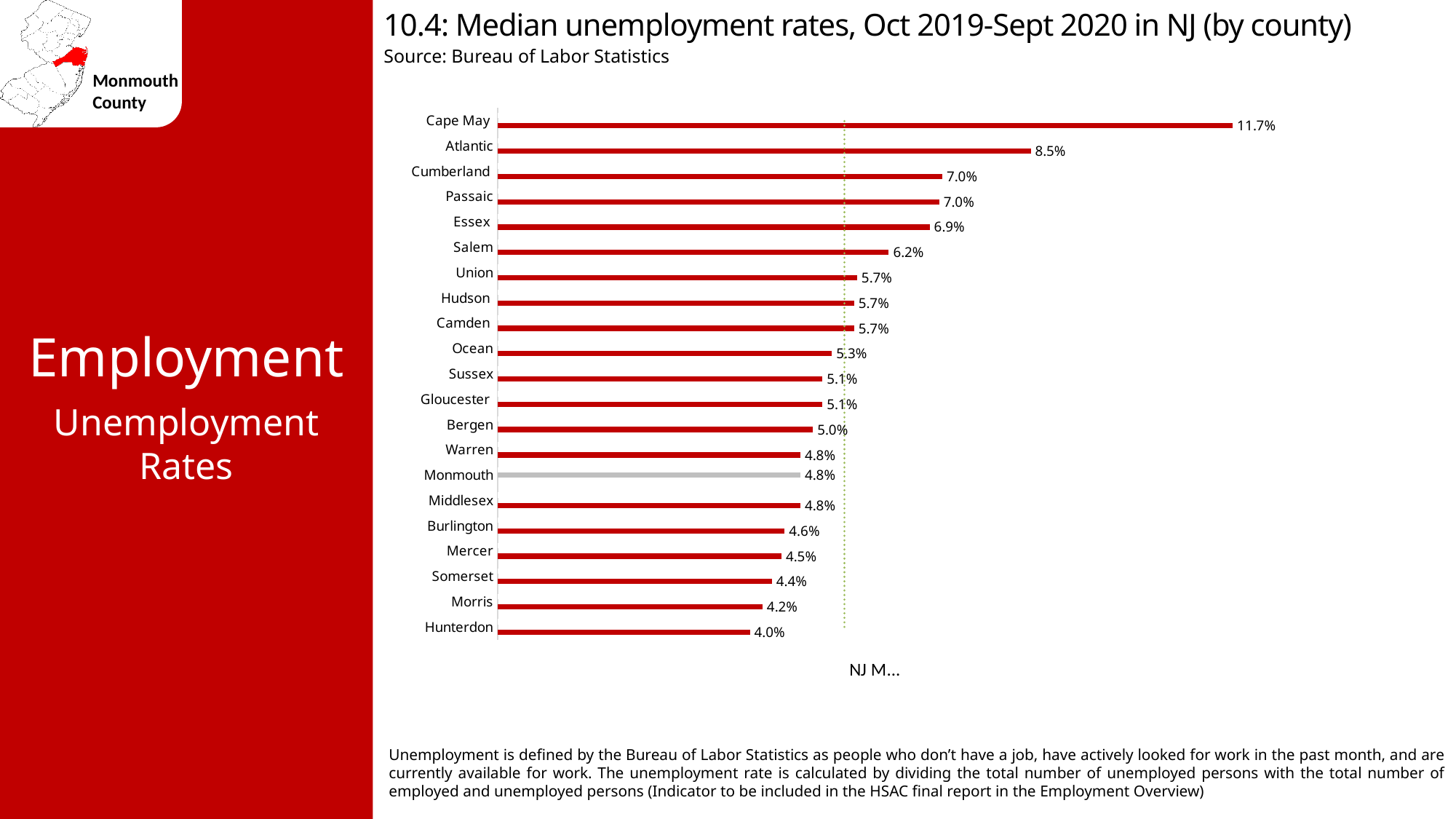
What is the difference between the median unemployment rates of Cape May and Atlantic? 3.2% Which county has the lowest median unemployment rate? Hunterdon What is the median unemployment rate for Cape May? 11.7% What is the median unemployment rate for Atlantic? 8.5% What type of chart is used to show the median unemployment rates? Bar chart Which county has the highest median unemployment rate? Cape May Which county's bar is shown in grey instead of red? Monmouth What is the median unemployment rate for Hunterdon? 4.0% What is the difference between the median unemployment rates of Monmouth and Hunterdon? 0.8% What is the median unemployment rate for Monmouth? 4.8% Which county has a higher median unemployment rate, Salem or Ocean? Salem How many counties are shown in the chart? 21